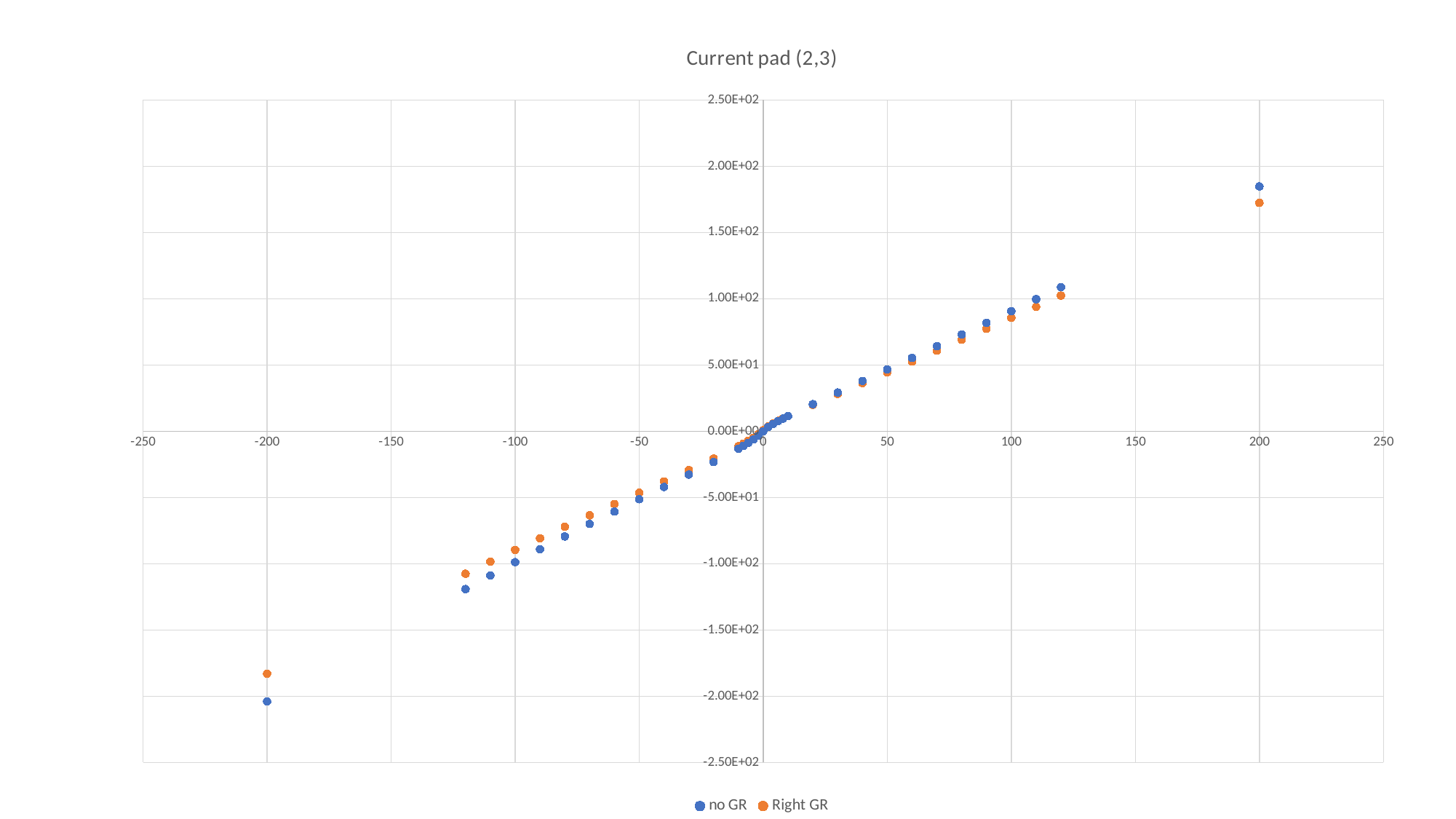
At x = 200, which series has the larger value, no GR or Right GR? no GR Is the value of the Right GR series at x = 200 greater or less than 2.00E+02? less What is the title of the chart? Current pad (2,3) Is the value of the no GR series at x = -120 greater or less than -1.00E+02? less Is the value of the Right GR series at x = -200 greater or less than -2.00E+02? greater What kind of chart is shown on the slide? Scatter chart Which series reaches the lowest plotted value on the chart? no GR Which series is plotted in orange? Right GR How many series does the legend list? 2 Do the plotted values rise or fall as the x value increases? Rise